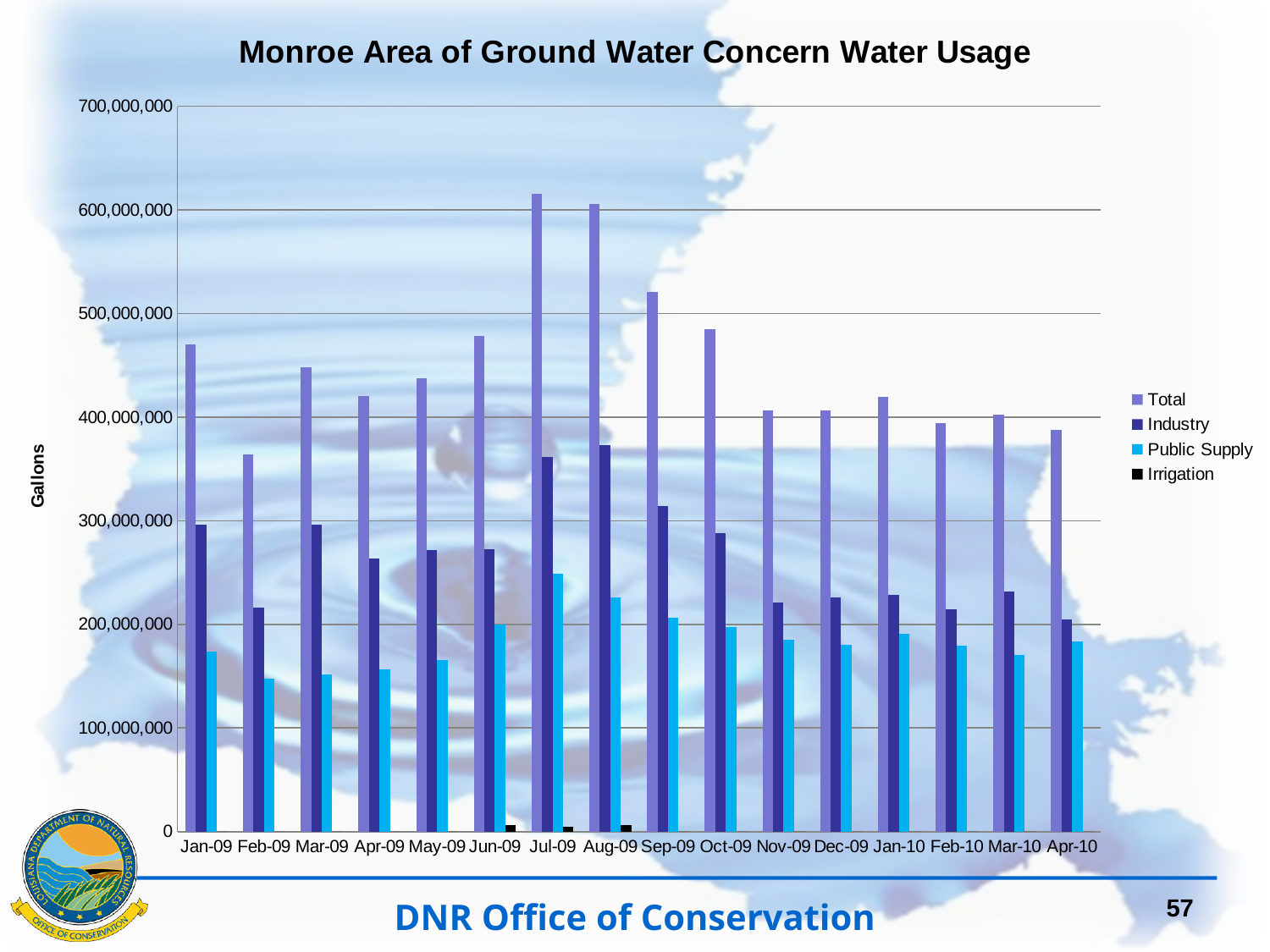
Is the Public Supply value for Jan-09 greater or less than 200,000,000? less Which month has the lowest Total water usage? Feb-09 How many series does the chart's legend list? 4 Which month has the highest Total water usage? Jul-09 Which is larger, the Total value for Jan-09 or the Total value for Feb-09? Jan-09 Is the Industry value for Jul-09 greater or less than 300,000,000? greater Is the Total value for Jul-09 greater or less than 600,000,000? greater Which month has the highest Public Supply water usage? Jul-09 How many months are shown along the x axis of the chart? 16 Does the Total water usage generally rise or fall from Jul-09 to Oct-09? Fall What is the label on the vertical axis of the chart? Gallons What kind of chart is shown on the slide? Bar chart